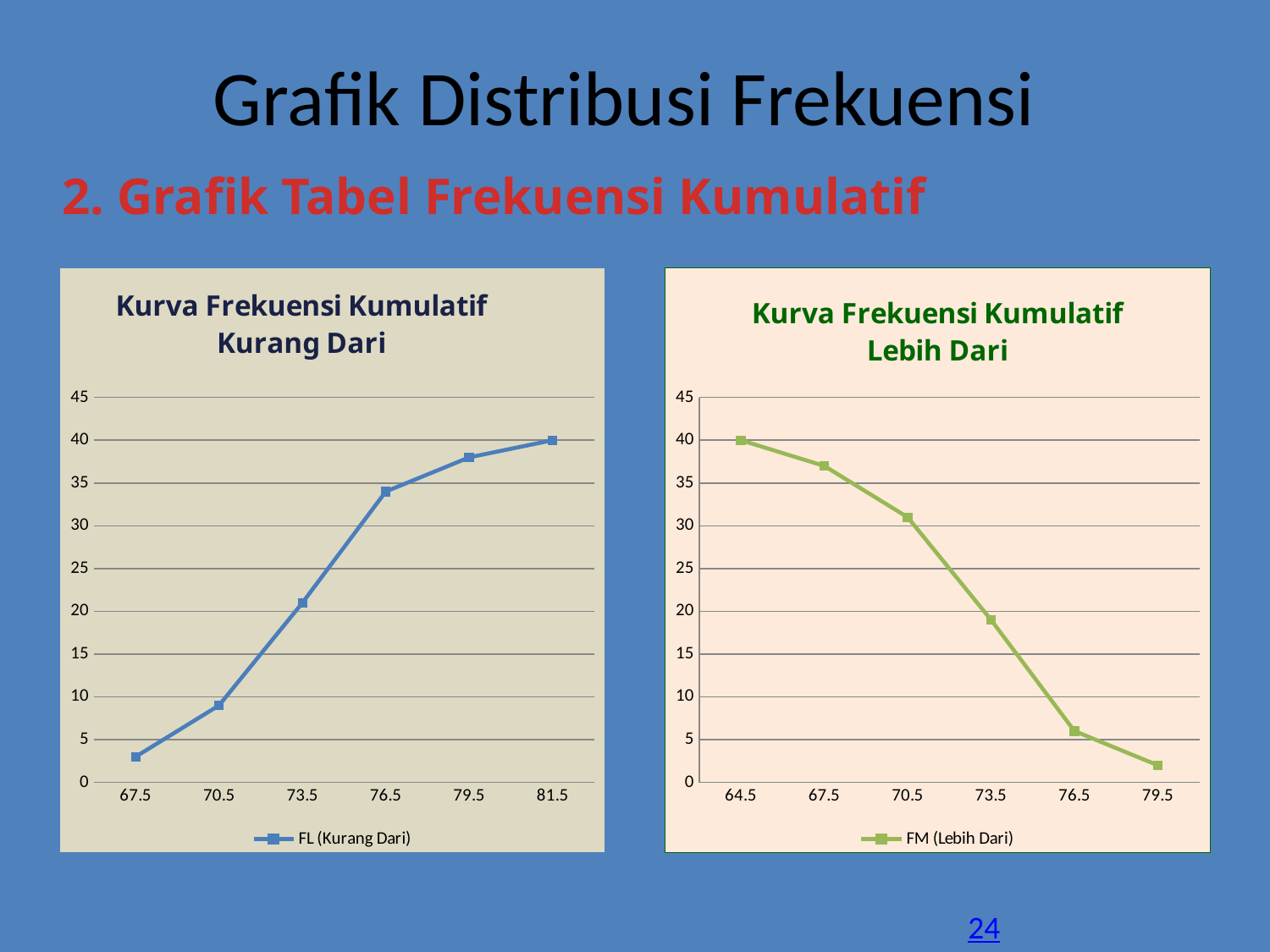
In the "Kurva Frekuensi Kumulatif Lebih Dari" chart, what is the value at 64.5? 40 In the "Kurva Frekuensi Kumulatif Lebih Dari" chart, which x-axis value has the lowest plotted value? 79.5 In the "Kurva Frekuensi Kumulatif Lebih Dari" chart, do the values rise or fall as the x-axis values increase? fall In the "Kurva Frekuensi Kumulatif Kurang Dari" chart, is the value at 67.5 greater or less than 5? less What type of chart is the "Kurva Frekuensi Kumulatif Kurang Dari" chart? line chart How many data points are plotted in the "Kurva Frekuensi Kumulatif Lebih Dari" chart? 6 In the "Kurva Frekuensi Kumulatif Kurang Dari" chart, what is the value at 81.5? 40 What is the legend entry of the "Kurva Frekuensi Kumulatif Kurang Dari" chart? FL (Kurang Dari) In the "Kurva Frekuensi Kumulatif Lebih Dari" chart, is the value at 76.5 greater or less than 10? less In the "Kurva Frekuensi Kumulatif Kurang Dari" chart, do the values rise or fall as the x-axis values increase? rise